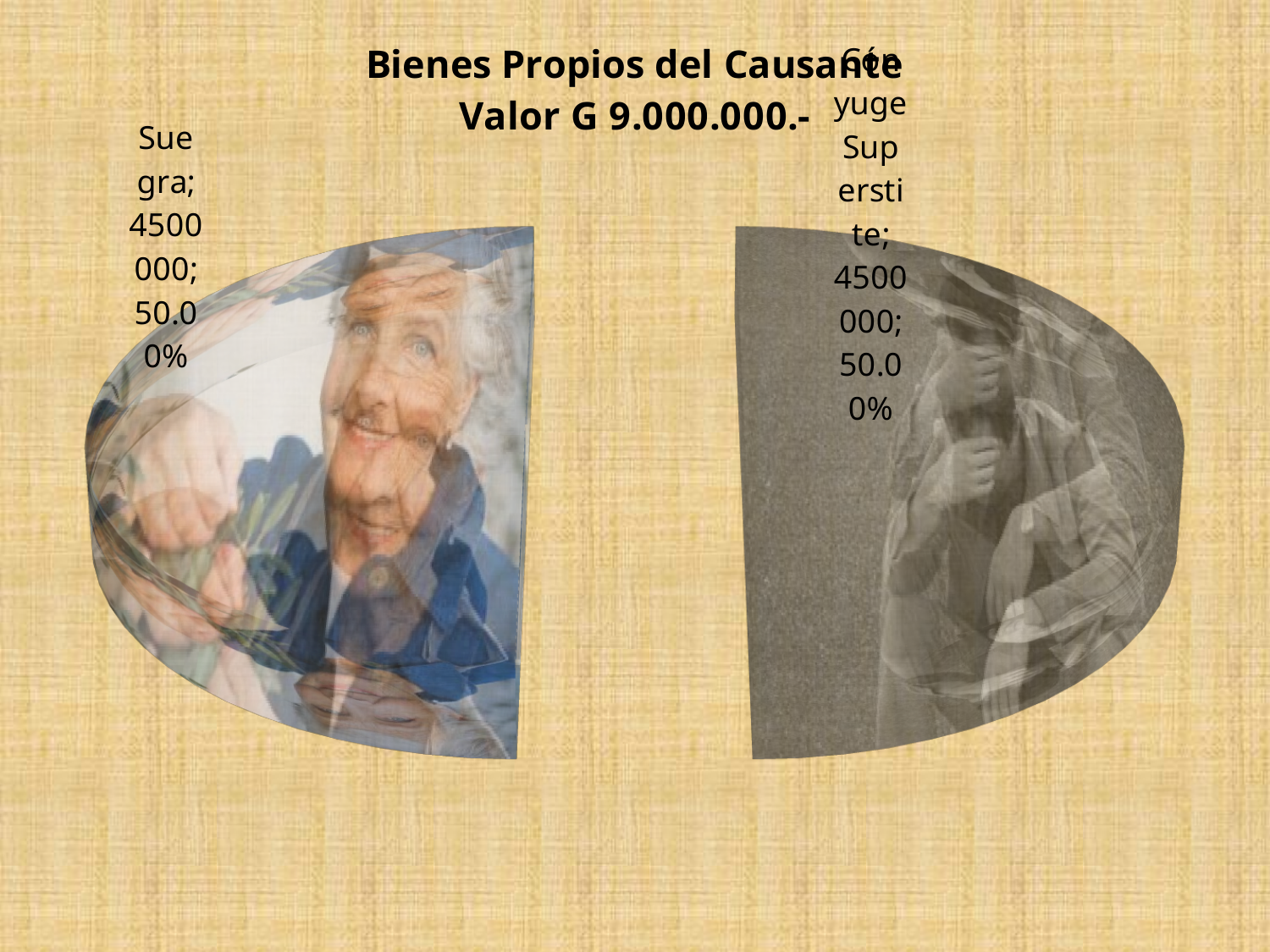
Is the value for Suegra greater or less than 4000000? greater What is the value shown for Cónyuge Superstite? 4500000 What share of the pie does the Suegra slice represent? 50.00% What kind of chart is shown on the slide? pie chart What is the total of the two slice values shown on the chart? 9000000 How many slices does the pie chart have? 2 What share of the pie does the Cónyuge Superstite slice represent? 50.00% What is the title of the chart? Bienes Propios del Causante Valor G 9.000.000.- Which slice is on the left side of the slide, Suegra or Cónyuge Superstite? Suegra What is the value shown for Suegra? 4500000